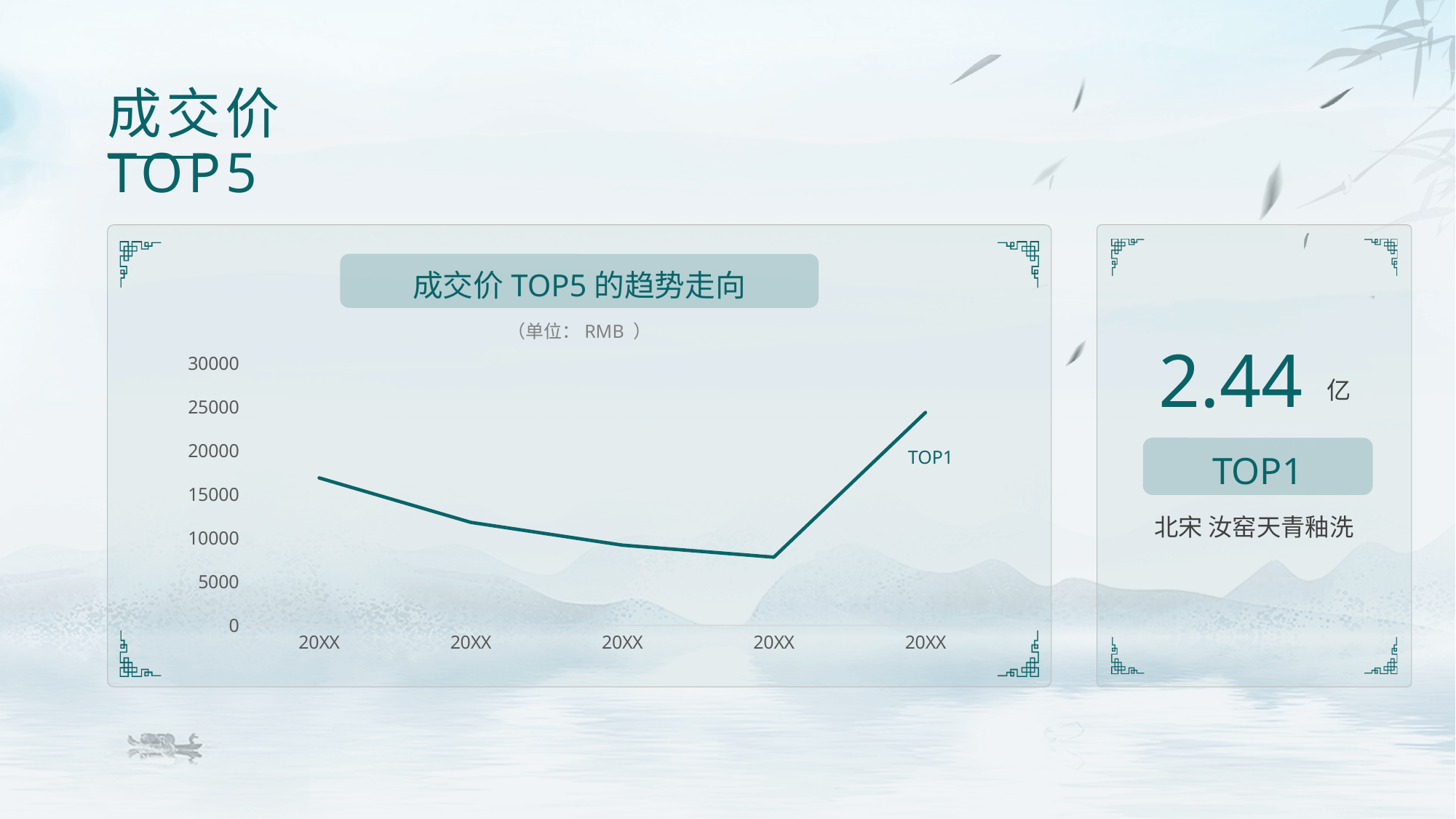
Which data point has the highest value on the line? the last (fifth) point What unit is stated for the chart's values? RMB Is the value of the first data point greater or less than 15000? greater What kind of chart is shown on the slide? line chart Which is larger, the value of the first data point or the value of the second data point? the first data point Is the value of the last data point greater or less than 20000? greater Is the value of the second data point greater or less than 10000? greater How do the values change along the x axis? they fall over the first four points, then rise sharply at the last point How many data points are plotted on the line? 5 What is the title of the chart? 成交价 TOP5 的趋势走向 Which is larger, the value of the first data point or the value of the last data point? the last data point